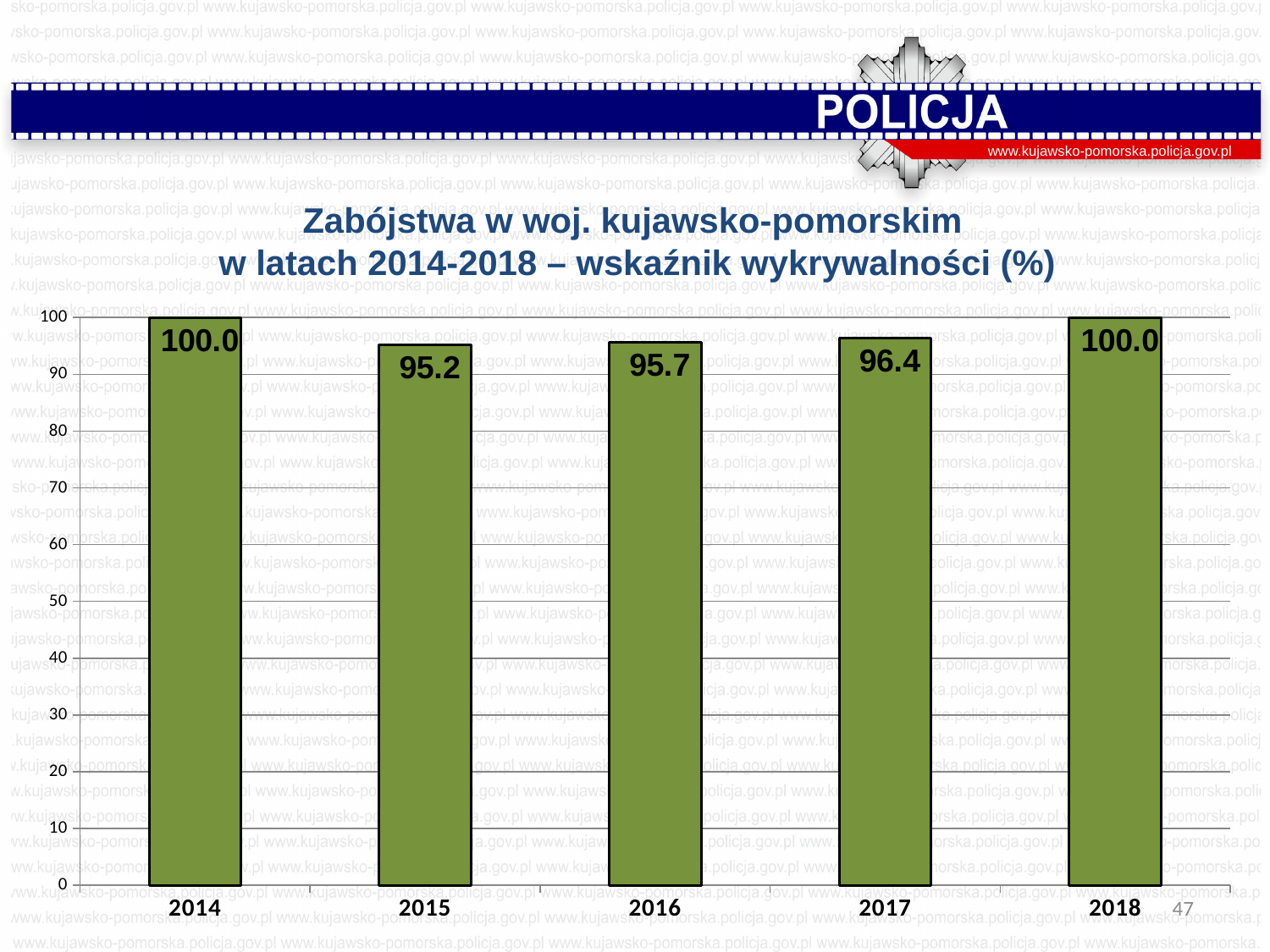
What is the value shown for 2016? 95.7 What is the title of the chart? Zabójstwa w woj. kujawsko-pomorskim w latach 2014-2018 – wskaźnik wykrywalności (%) Which year has the lowest value on the chart? 2015 Which is larger, the value for 2016 or the value for 2017? 2017 What kind of chart is shown on the slide? bar chart Is the value for 2015 greater or less than 90? greater How many years are shown on the x axis? 5 What is the difference between the values for 2018 and 2015? 4.8 What is the value shown for 2017? 96.4 What is the detection rate value shown for 2015? 95.2 What is the value shown for 2014? 100.0 What is the difference between the values for 2017 and 2016? 0.7